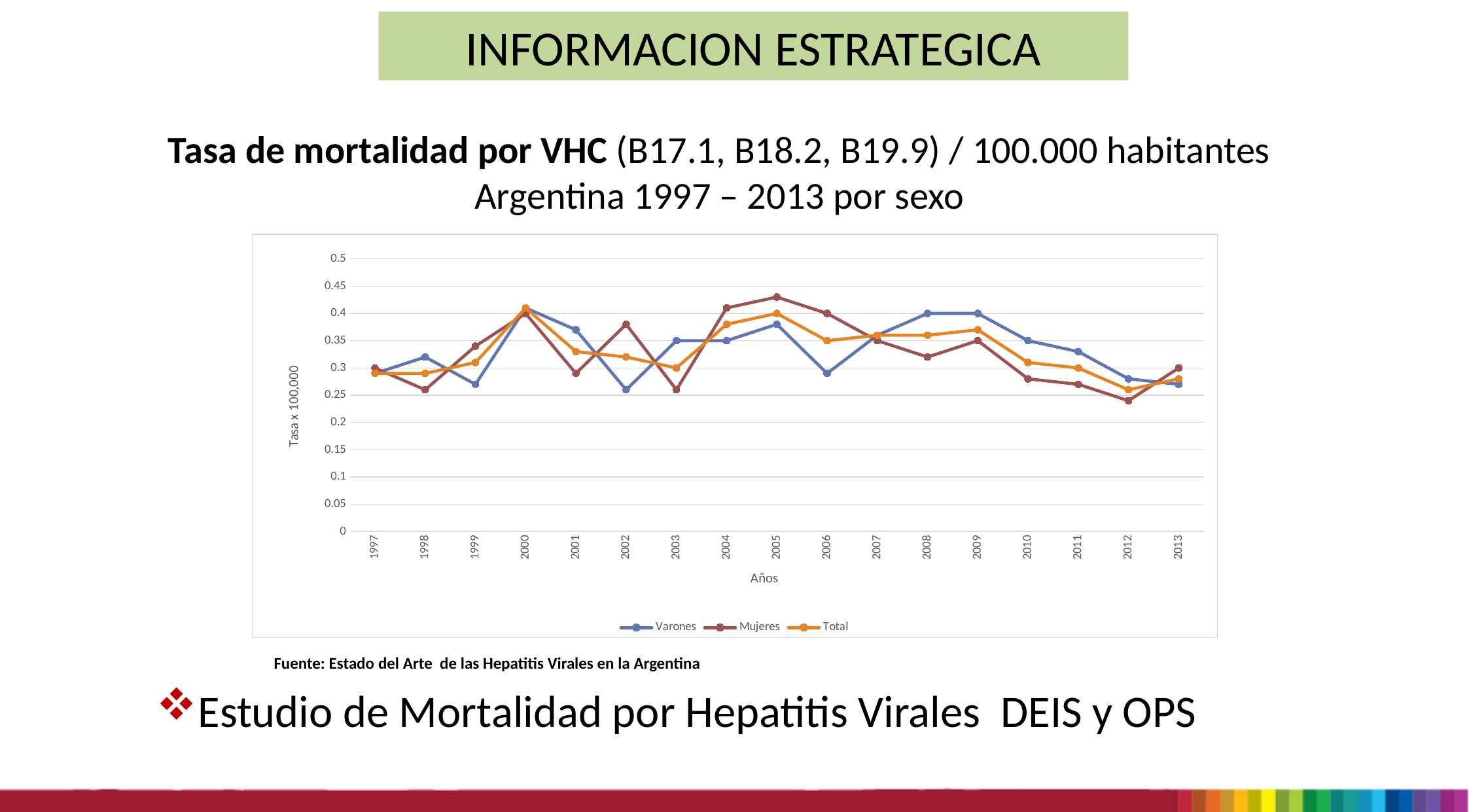
What is the value for Varones in 2008? 0.4 What is the value for Total in 2005? 0.4 How many years are plotted along the x axis? 17 What is the value for Mujeres in 2006? 0.4 What kind of chart is shown on the slide? line chart In 2002, which series has the higher value, Varones or Mujeres? Mujeres In 2008, which series has the higher value, Varones or Mujeres? Varones In which year is the Mujeres series at its highest? 2005 Is the value for Mujeres in 2005 greater or less than 0.4? greater How many series does the chart legend list? 3 What is the title of the vertical axis? Tasa x 100,000 Is the value for Varones in 1999 greater or less than 0.3? less